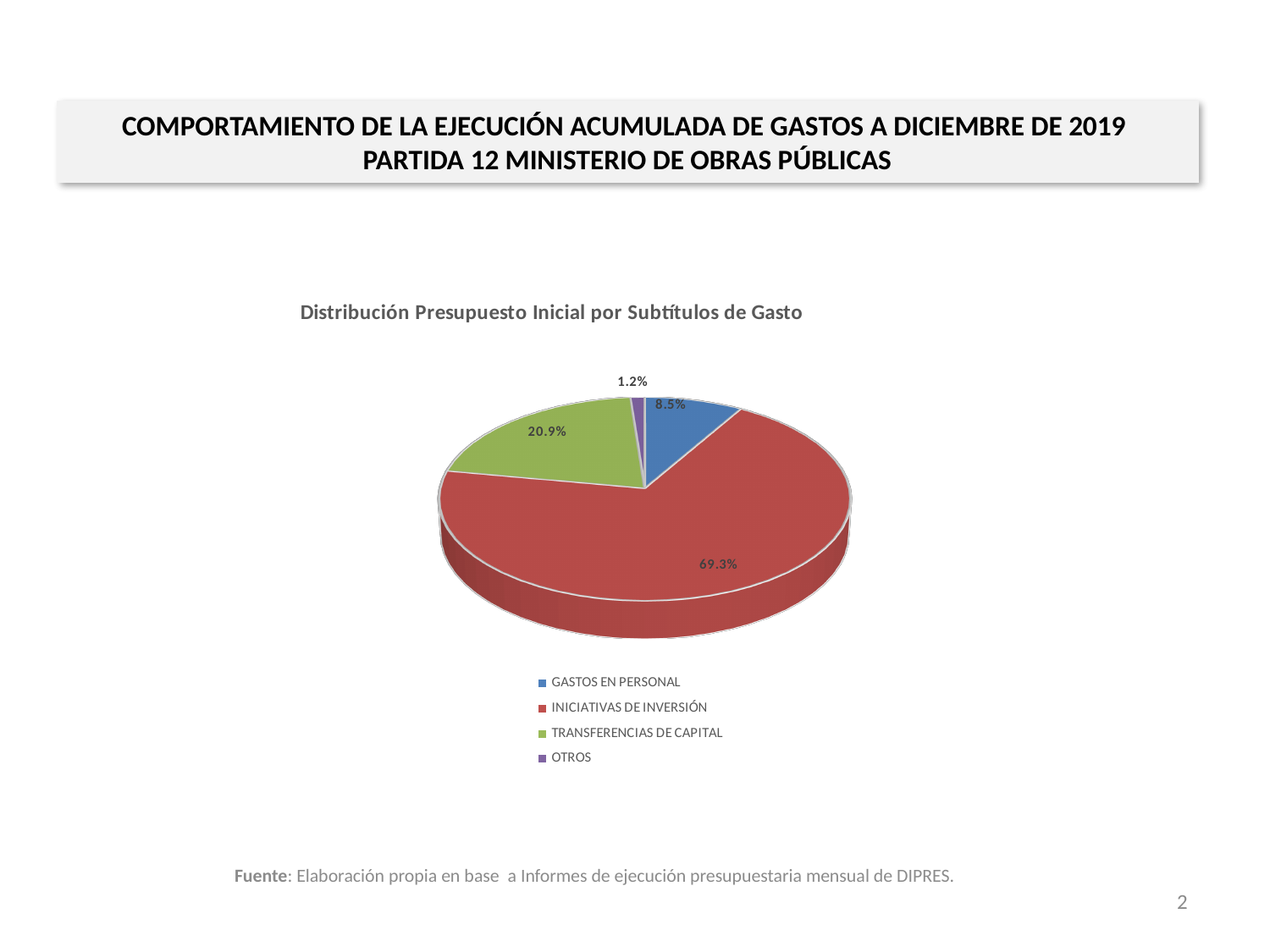
Which is larger, the share for TRANSFERENCIAS DE CAPITAL or the share for GASTOS EN PERSONAL? TRANSFERENCIAS DE CAPITAL How many categories does the legend list? 4 What is the difference in percentage points between INICIATIVAS DE INVERSIÓN and TRANSFERENCIAS DE CAPITAL? 48.4 What colour is the slice for INICIATIVAS DE INVERSIÓN? Red What share of the pie does GASTOS EN PERSONAL represent? 8.5% What share of the pie does TRANSFERENCIAS DE CAPITAL represent? 20.9% Which category has the largest slice of the pie? INICIATIVAS DE INVERSIÓN What share of the pie does INICIATIVAS DE INVERSIÓN represent? 69.3% What kind of chart is shown on the slide? Pie chart What is the title of the chart? Distribución Presupuesto Inicial por Subtítulos de Gasto Which category has the smallest slice of the pie? OTROS